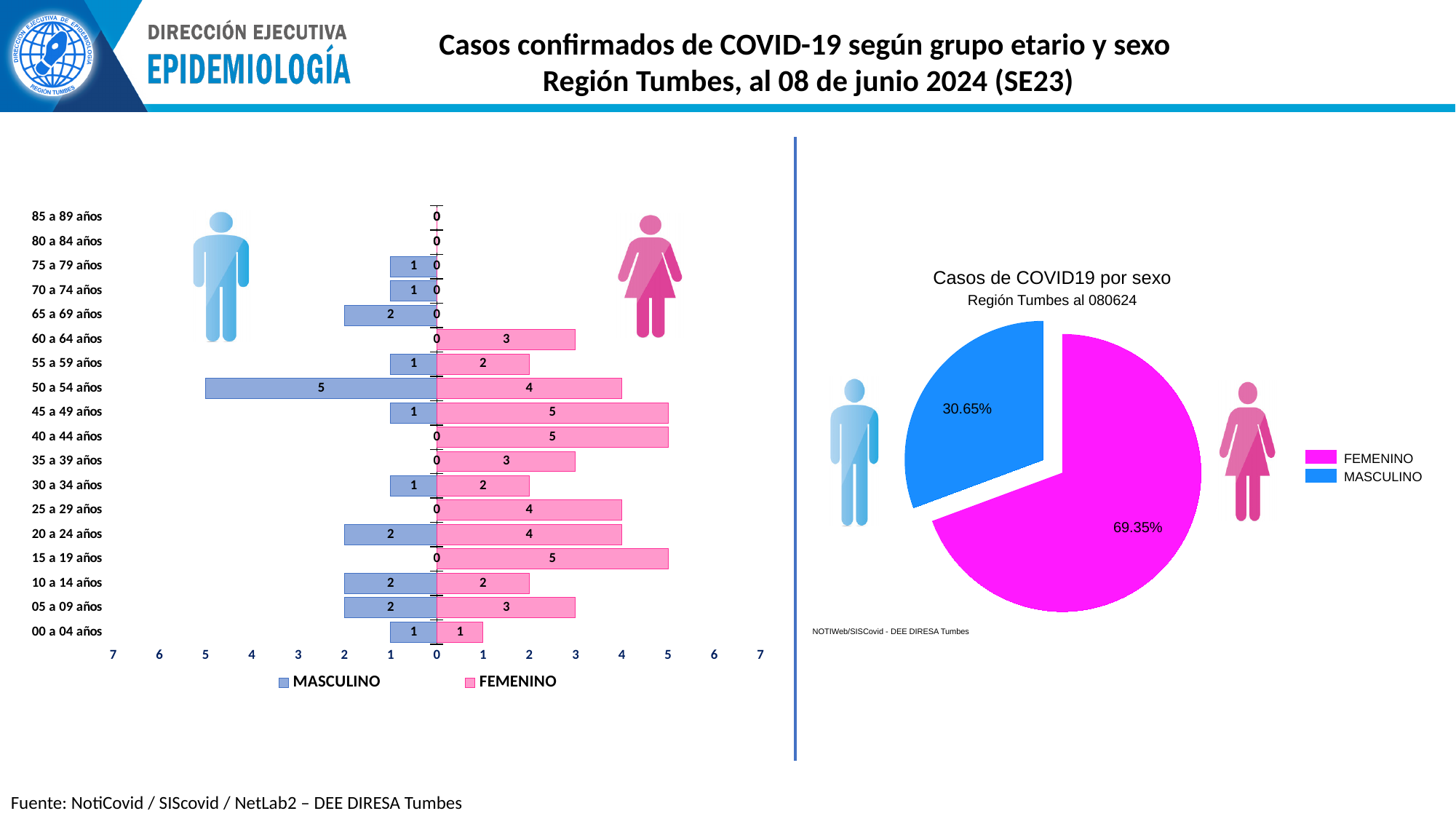
In the pie chart 'Casos de COVID19 por sexo', what share is FEMENINO? 69.35% In the left chart (cases by age group and sex), which is larger for the 50 a 54 años group, the MASCULINO or the FEMENINO value? MASCULINO In the left chart (cases by age group and sex), what is the difference between the FEMENINO and MASCULINO values for the 20 a 24 años group? 2 In the left chart (cases by age group and sex), how many series does the legend list? 2 In the pie chart 'Casos de COVID19 por sexo', which slice is larger, FEMENINO or MASCULINO? FEMENINO In the left chart (cases by age group and sex), what is the FEMENINO value for the 45 a 49 años group? 5 In the pie chart 'Casos de COVID19 por sexo', what share is MASCULINO? 30.65% In the left chart (cases by age group and sex), how many age groups are shown on the vertical axis? 18 In the left chart (cases by age group and sex), which age group has the highest MASCULINO value? 50 a 54 años In the left chart (cases by age group and sex), what is the FEMENINO value for the 60 a 64 años group? 3 In the left chart (cases by age group and sex), what is the MASCULINO value for the 50 a 54 años group? 5 What kind of chart is the left chart showing cases by age group and sex? Bar chart